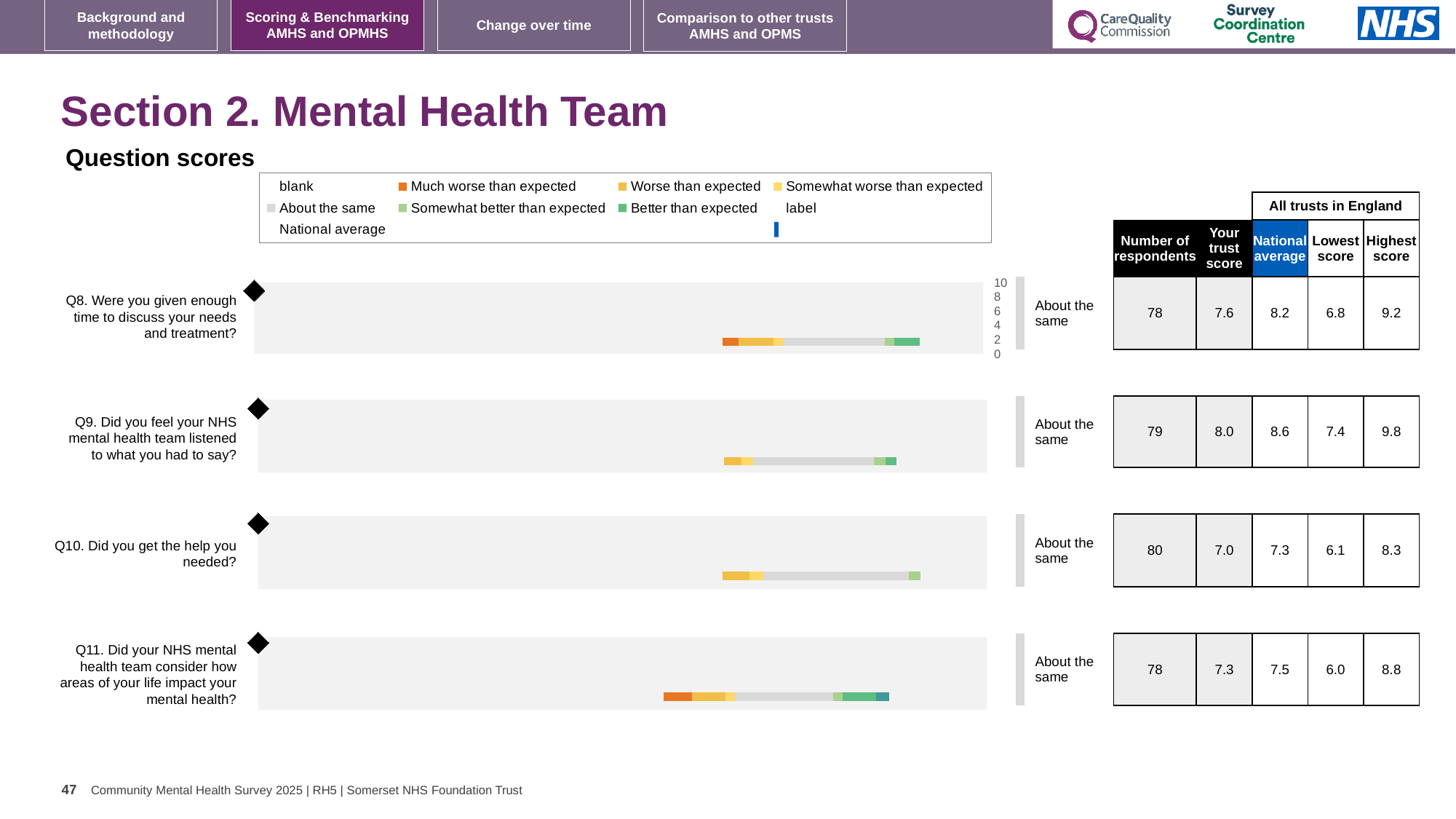
What is the highest score among all trusts in England for Q8? 9.2 What type of chart is used to show the question scores for Q8 to Q11? bar chart How many questions (Q8 to Q11) have a score bar plotted on the slide? 4 Which question has the highest 'Your trust score' among Q8 to Q11? Q9 What benchmark category is shown next to the bar for Q10? About the same What is the lowest score among all trusts in England for Q11 (Did your NHS mental health team consider how areas of your life impact your mental health)? 6.0 What is the 'Your trust score' value for Q8 (Were you given enough time to discuss your needs and treatment)? 7.6 Which question has the lowest 'Your trust score' among Q8 to Q11? Q10 What is the difference between the national average and the trust score for Q8? 0.6 How many respondents answered Q10 (Did you get the help you needed)? 80 What is the national average score for Q9 (Did you feel your NHS mental health team listened to what you had to say)? 8.6 For Q9, which is larger: the trust score or the national average? National average